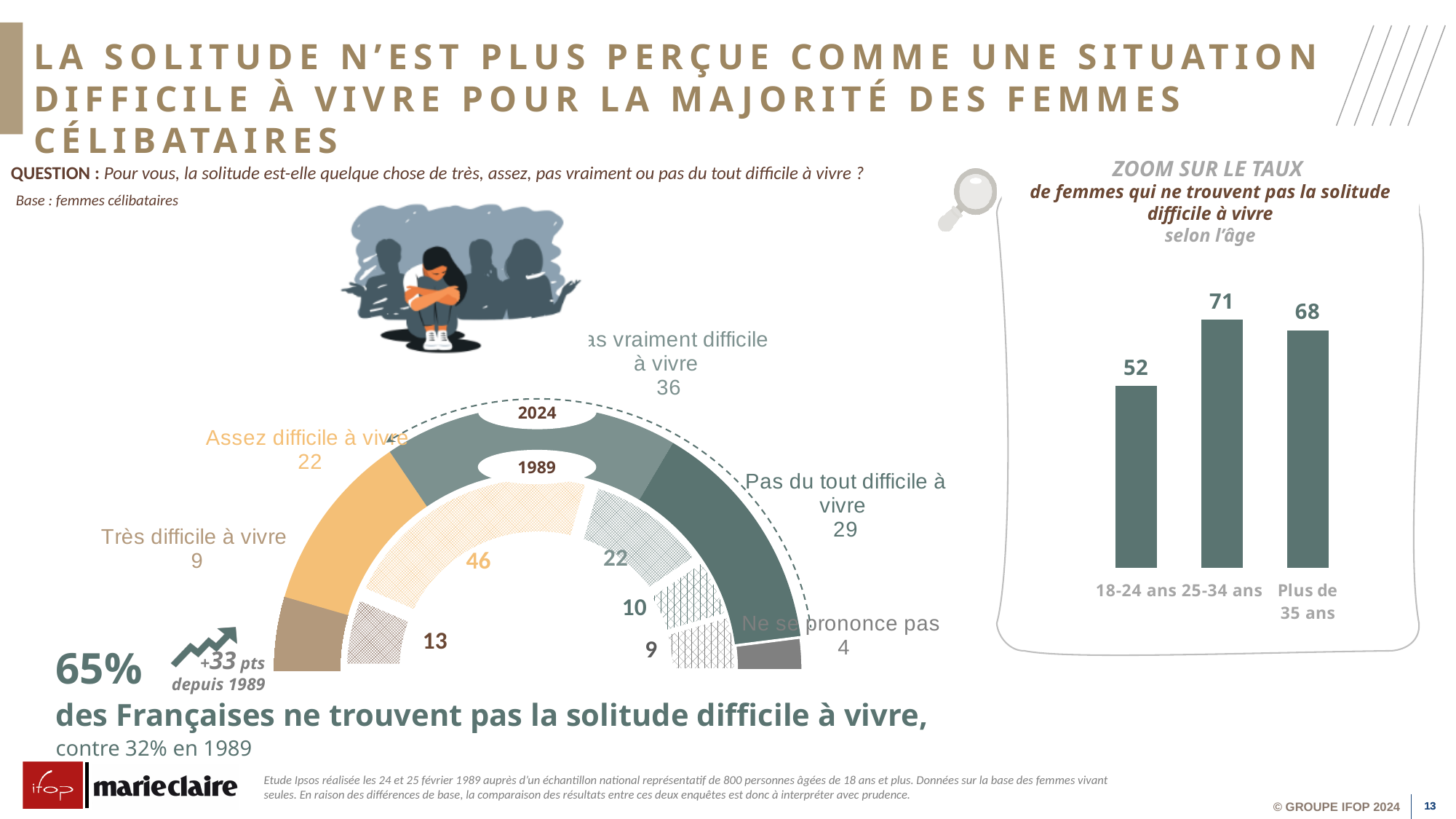
In the bar chart on the right (Zoom sur le taux selon l'âge), what is the value for 25-34 ans? 71 In the semi-circular chart in the centre, which 2024 category has the lowest value? Ne se prononce pas In the bar chart on the right (Zoom sur le taux selon l'âge), how many age groups are shown? 3 In the bar chart on the right (Zoom sur le taux selon l'âge), which age group has the lowest value? 18-24 ans In the semi-circular chart in the centre, which two years are compared by the outer and inner rings? 2024 and 1989 What kind of chart is the chart on the right (Zoom sur le taux selon l'âge)? Bar chart In the semi-circular chart in the centre, what is the 2024 value for 'Assez difficile à vivre'? 22 In the bar chart on the right (Zoom sur le taux selon l'âge), what is the value for 18-24 ans? 52 In the semi-circular chart in the centre, what is the 2024 value for 'Pas vraiment difficile à vivre'? 36 In the semi-circular chart in the centre, which is larger in 2024: 'Pas du tout difficile à vivre' or 'Très difficile à vivre'? Pas du tout difficile à vivre In the bar chart on the right (Zoom sur le taux selon l'âge), what is the difference between the values for 25-34 ans and 18-24 ans? 19 In the bar chart on the right (Zoom sur le taux selon l'âge), which age group has the highest value? 25-34 ans